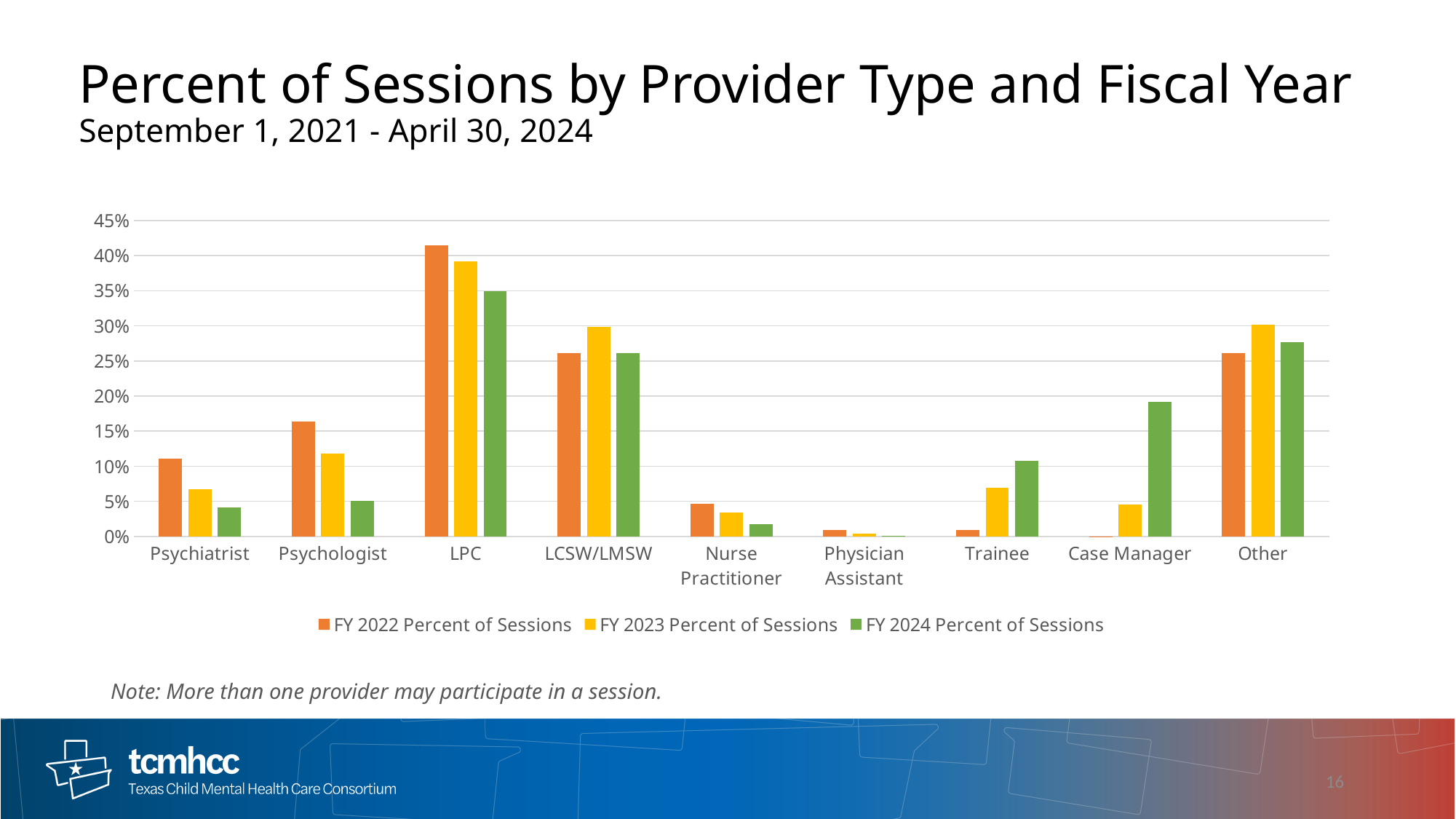
Is the FY 2022 Percent of Sessions for Psychologist greater or less than 15%? greater How many series does the legend list? 3 For Psychiatrist, do the values rise or fall from FY 2022 to FY 2024? fall Which provider type has the lowest FY 2024 Percent of Sessions? Physician Assistant Is the FY 2022 Percent of Sessions for LPC greater or less than 40%? greater What kind of chart is shown on the slide? Bar chart For Trainee, do the values rise or fall from FY 2022 to FY 2024? rise How many provider type categories are shown on the x axis? 9 Which provider type has the highest FY 2022 Percent of Sessions? LPC For Trainee, which is larger: the FY 2022 Percent of Sessions or the FY 2024 Percent of Sessions? FY 2024 Percent of Sessions What colour represents the FY 2024 Percent of Sessions series? Green Is the FY 2024 Percent of Sessions for Case Manager greater or less than 15%? greater